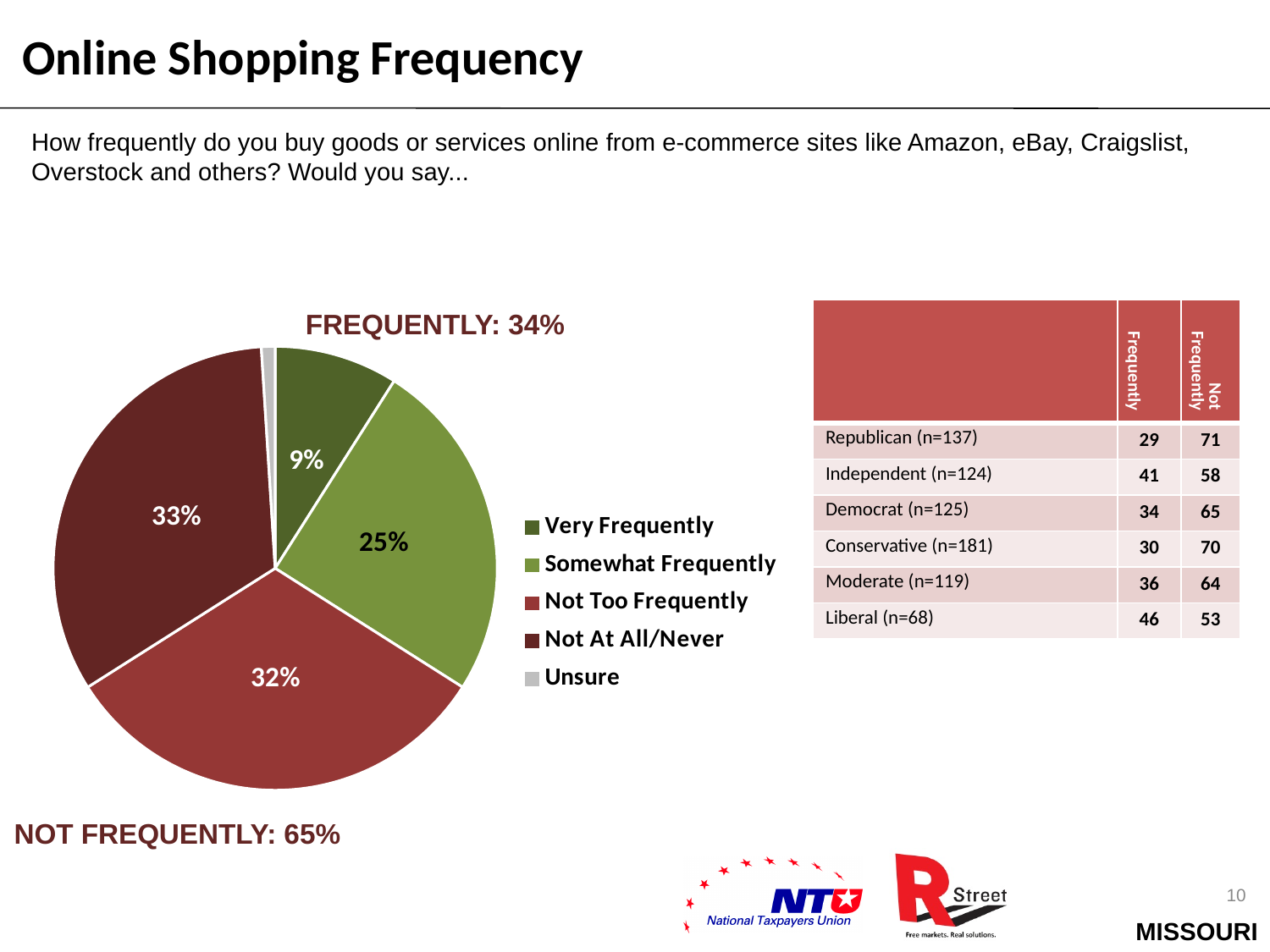
How many entries does the pie chart legend list? 5 What percentage of respondents said they shop online Very Frequently? 9% Which slice of the pie chart is the largest? Not At All/Never What combined percentage does the slide give for FREQUENTLY? 34% What is the difference between the Not Too Frequently share and the Very Frequently share? 23% What combined percentage does the slide give for NOT FREQUENTLY? 65% What kind of chart is shown on the slide? pie chart What percentage of respondents said Not At All/Never? 33% Which is larger, the Somewhat Frequently slice or the Very Frequently slice? Somewhat Frequently What percentage of respondents said Somewhat Frequently? 25% What percentage of respondents said Not Too Frequently? 32% Which slice of the pie chart is the smallest? Unsure